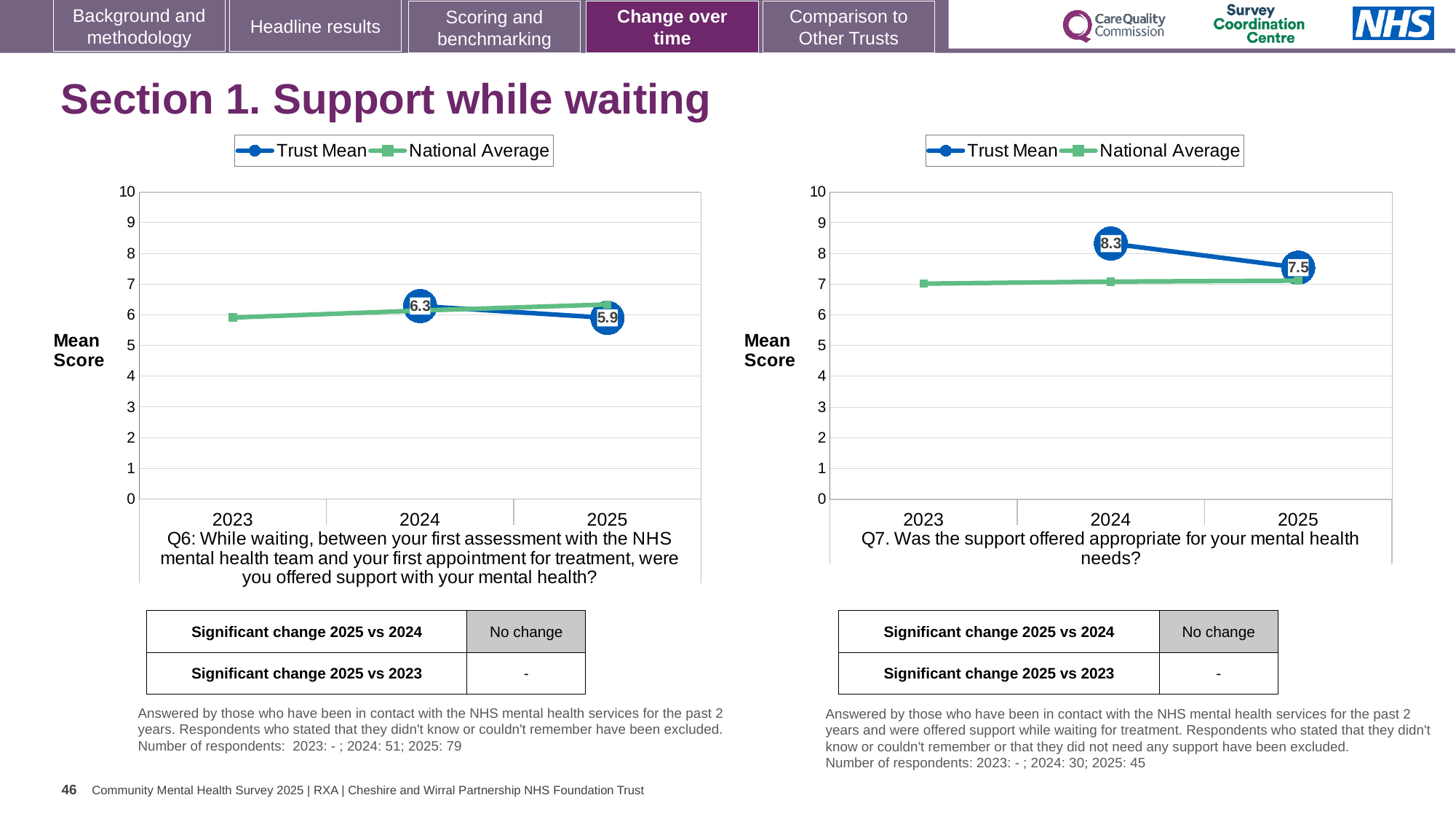
In the Q6 chart on the left, what is the difference between the Trust Mean in 2024 and in 2025? 0.4 In the Q7 chart on the right, is the National Average for 2023 greater or less than 8? less In the Q6 chart on the left, is the National Average for 2023 greater or less than 5? greater In the Q7 chart on the right, what is the Trust Mean for 2025? 7.5 In the Q7 chart on the right, what is the Trust Mean for 2024? 8.3 In the Q6 chart on the left, what is the Trust Mean for 2025? 5.9 How many series does the legend of the Q6 chart on the left list? 2 In the Q7 chart on the right, does the Trust Mean rise or fall from 2024 to 2025? fall In the Q7 chart on the right, is the Trust Mean for 2024 higher or lower than the National Average for 2024? higher In the Q7 chart on the right, by how much did the Trust Mean fall from 2024 to 2025? 0.8 In the Q6 chart on the left, what is the Trust Mean for 2024? 6.3 What kind of chart is the Q7 chart on the right? line chart